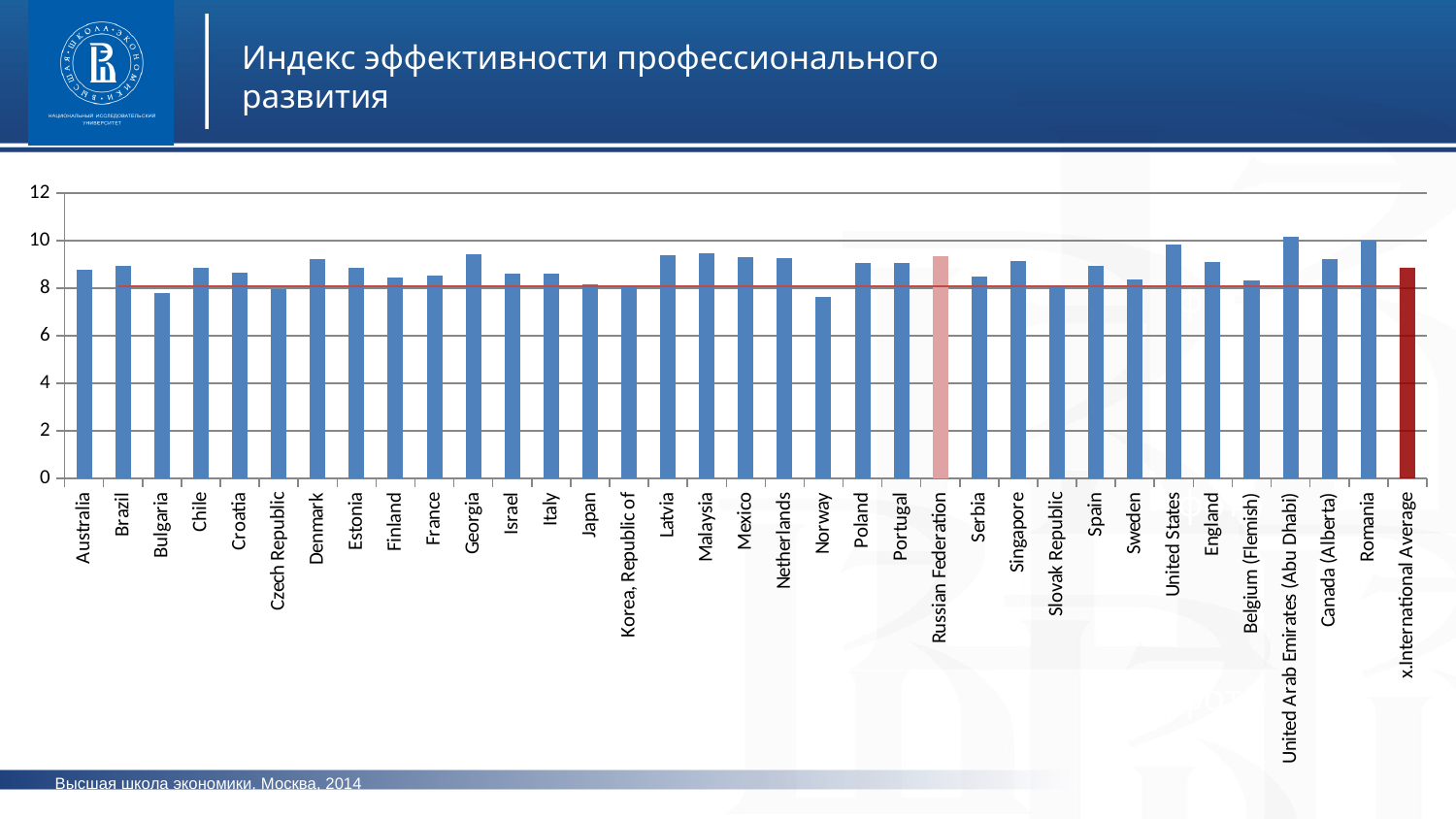
What kind of chart is shown on the slide? bar chart What is the title of the slide containing the chart? Индекс эффективности профессионального развития Which category has the highest bar in the chart? United Arab Emirates (Abu Dhabi) Is the value for United Arab Emirates (Abu Dhabi) greater or less than 10? greater Is the value for Bulgaria greater or less than 8? less Which is larger, the value for United States or the value for Norway? United States Which country's bar is highlighted in a light pink colour instead of blue? Russian Federation Is the value for Georgia greater or less than 8? greater Which is larger, the value for Russian Federation or the value for Sweden? Russian Federation How many categories are shown along the x axis of the chart? 35